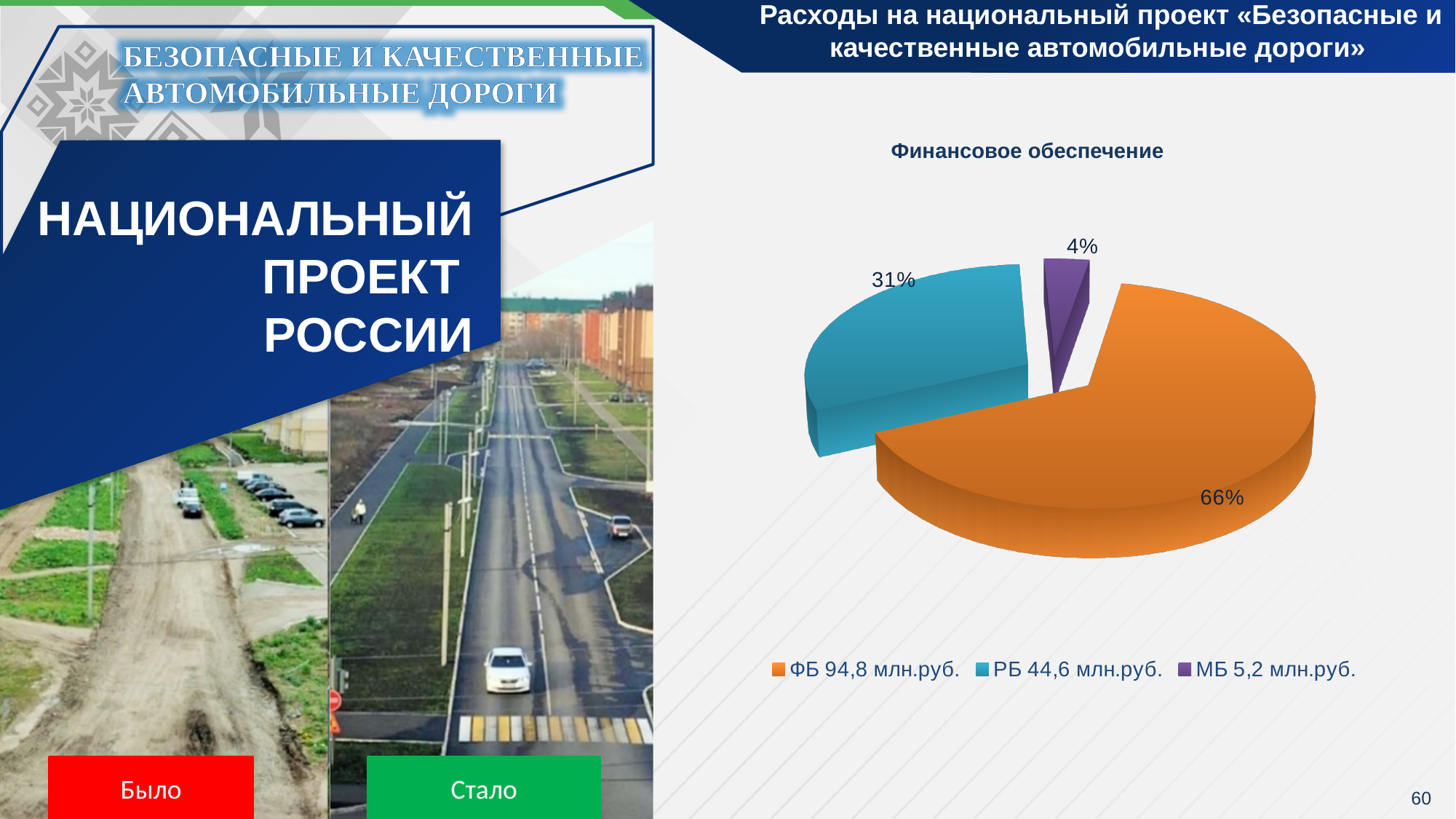
What amount is shown in the legend for МБ? 5,2 млн.руб. What is the title of the chart on the slide? Финансовое обеспечение What amount is shown in the legend for ФБ? 94,8 млн.руб. Which slice of the pie chart is the largest? ФБ What kind of chart is shown under the title «Финансовое обеспечение»? Pie chart What share of the pie does the МБ slice represent? 4% Which is larger, the share for РБ or the share for МБ? РБ How many entries does the legend of the pie chart list? 3 What share of the pie does the РБ slice represent? 31% Which slice of the pie chart is the smallest? МБ What share of the pie does the ФБ slice represent? 66% How many slices does the pie chart have? 3